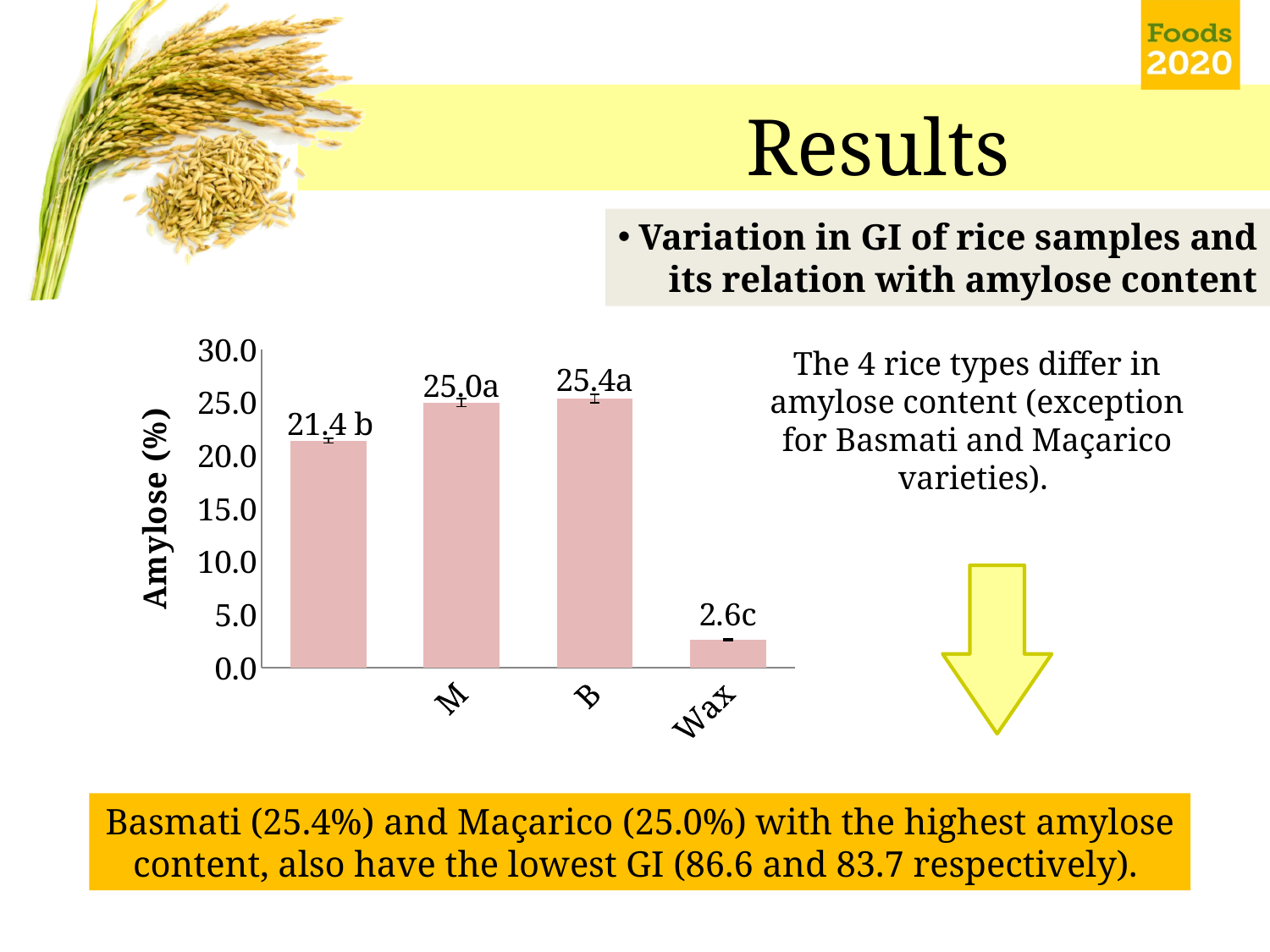
Which category has the highest amylose (%) in the chart? B What is the difference in amylose (%) between B and Wax? 22.8 What is the amylose value labelled on the bar for Wax? 2.6c What kind of chart is shown on the slide? bar chart What is the amylose value labelled on the bar for B? 25.4a What is the amylose value labelled on the bar for M? 25.0a What is the title of the vertical axis of the chart? Amylose (%) Is the amylose value for Wax greater or less than 5.0? less What is the difference in amylose (%) between B and M? 0.4 How many bars are plotted in the chart? 4 Which has a higher amylose (%), M or B? B Which category has the lowest amylose (%) in the chart? Wax